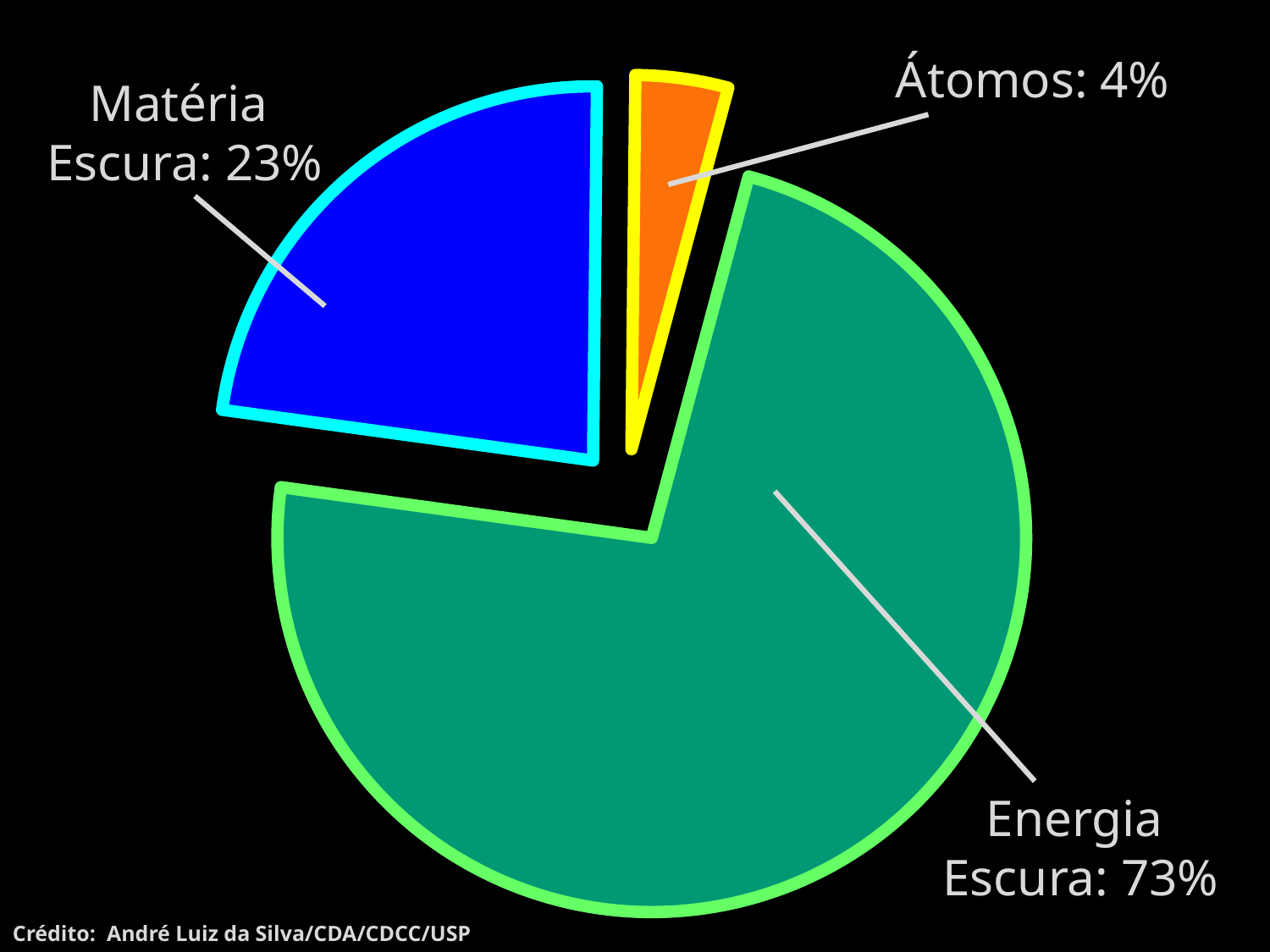
What is the difference in percentage points between Energia Escura and Matéria Escura? 50 What colour is the Átomos slice? orange What is the difference in percentage points between Matéria Escura and Átomos? 19 What share of the pie does Átomos represent? 4% Which slice of the pie is the smallest? Átomos Which is larger, the share for Matéria Escura or the share for Átomos? Matéria Escura What kind of chart is shown on the slide? pie chart Which slice of the pie is the largest? Energia Escura What share of the pie does Energia Escura represent? 73% What colour is the Energia Escura slice? green How many slices does the pie chart have? 3 What share of the pie does Matéria Escura represent? 23%